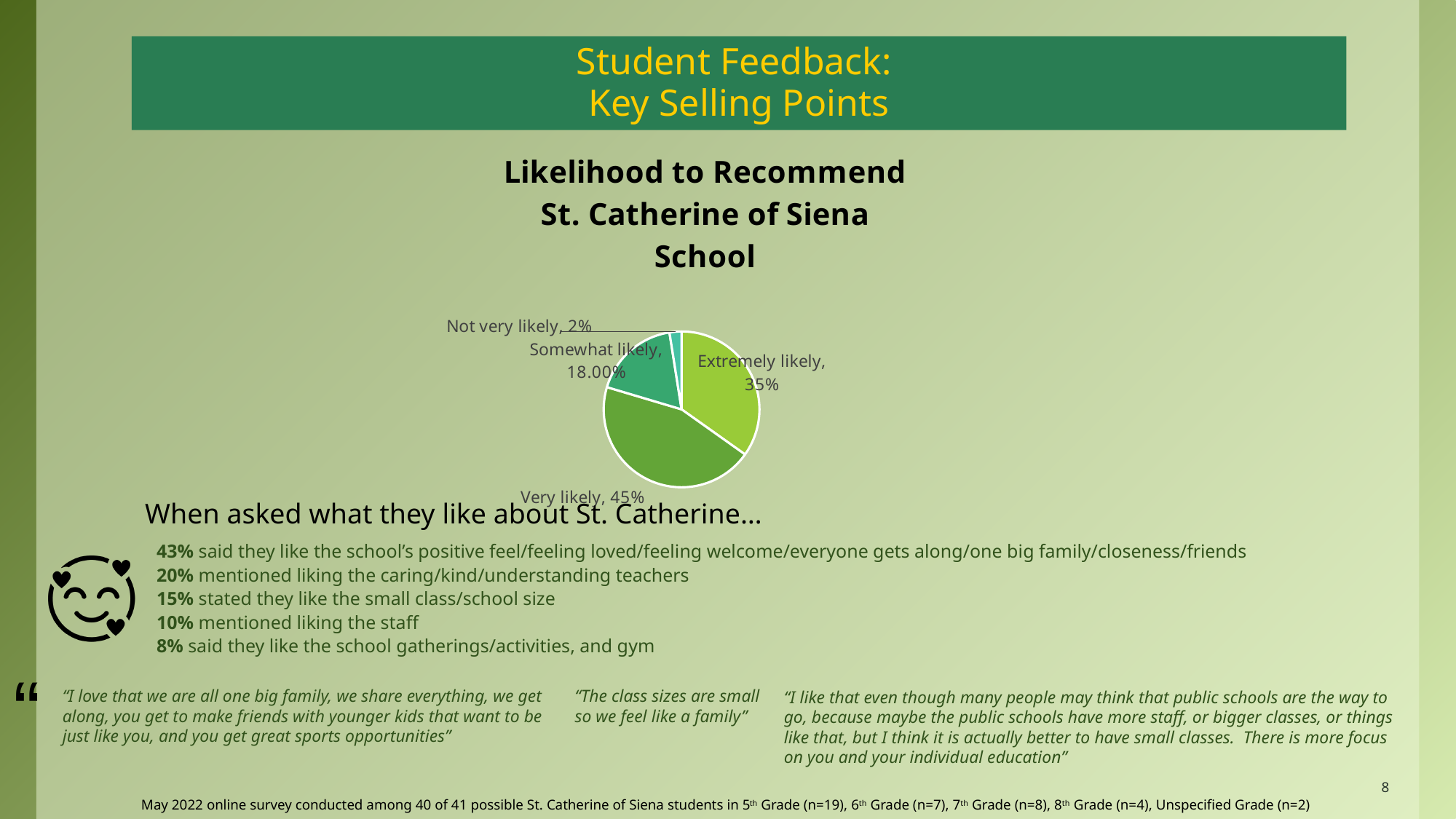
How many slices does the pie chart have? 4 What percentage of students said they are very likely to recommend the school? 45% Which category has the smallest share of the pie? Not very likely Which is larger, the 'Somewhat likely' slice or the 'Extremely likely' slice? Extremely likely What is the difference between the 'Very likely' and 'Extremely likely' percentages? 10% What type of chart is shown on the slide? pie chart What value is shown for the 'Not very likely' slice? 2% What is the title of the chart? Likelihood to Recommend St. Catherine of Siena School Which category has the largest share of the pie? Very likely What percentage of students said they are extremely likely to recommend the school? 35% What value is shown for the 'Somewhat likely' slice? 18.00% What is the combined percentage of 'Extremely likely' and 'Very likely' responses? 80%